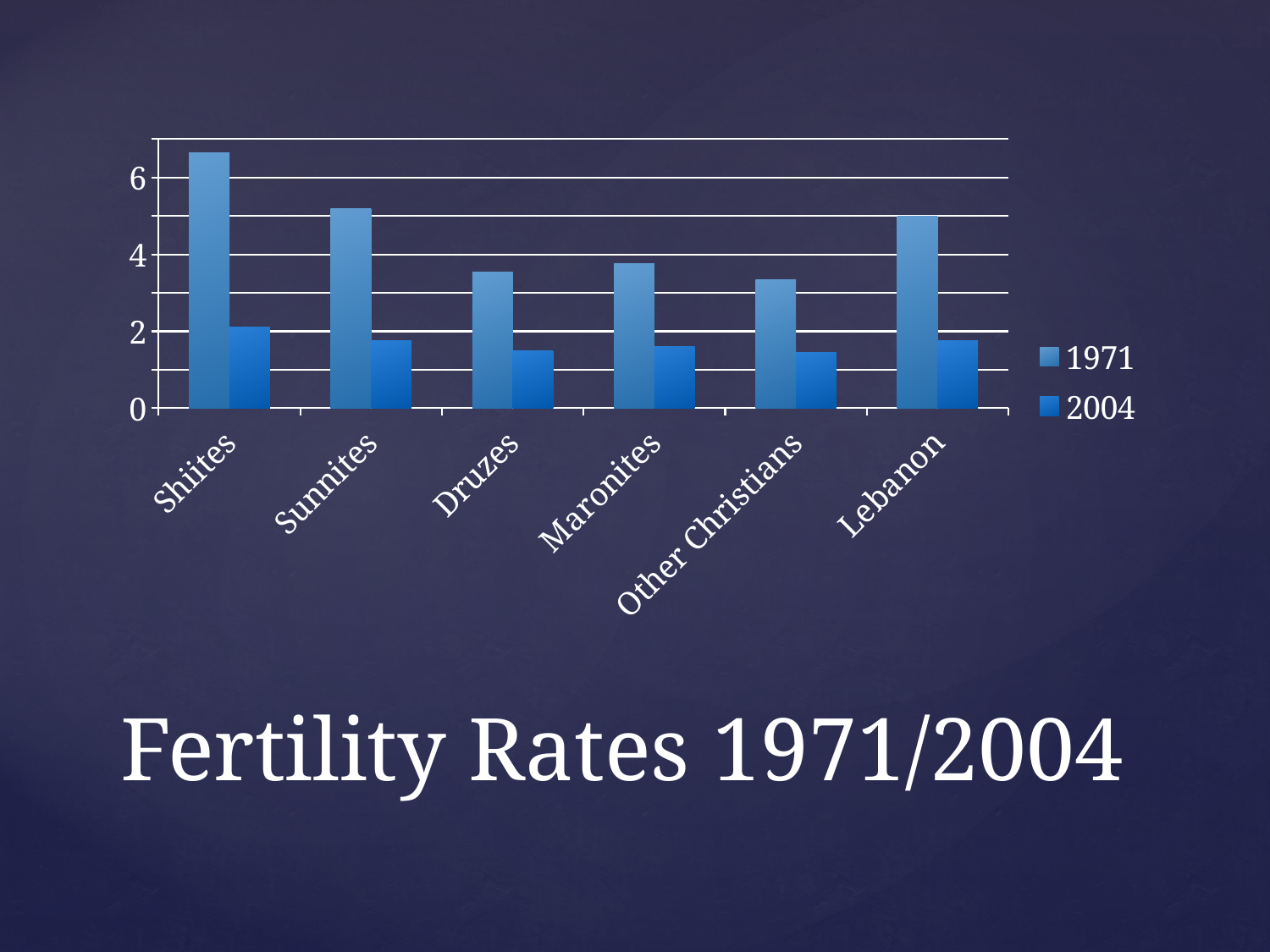
What are the two entries listed in the chart's legend? 1971 and 2004 Which category has the highest value for the 1971 series? Shiites Is the 1971 value for Other Christians greater or less than 4? less Which category has the highest value for the 2004 series? Shiites Is the 2004 value for Druzes greater or less than 2? less How many categories are shown on the x axis of the chart? 6 Is the 1971 value for Lebanon greater or less than 4? greater For Sunnites, which series has the larger value, 1971 or 2004? 1971 How many series does the chart's legend list? 2 What kind of chart is shown on the slide? bar chart Which is larger: the 1971 value for Shiites or the 1971 value for Sunnites? Shiites